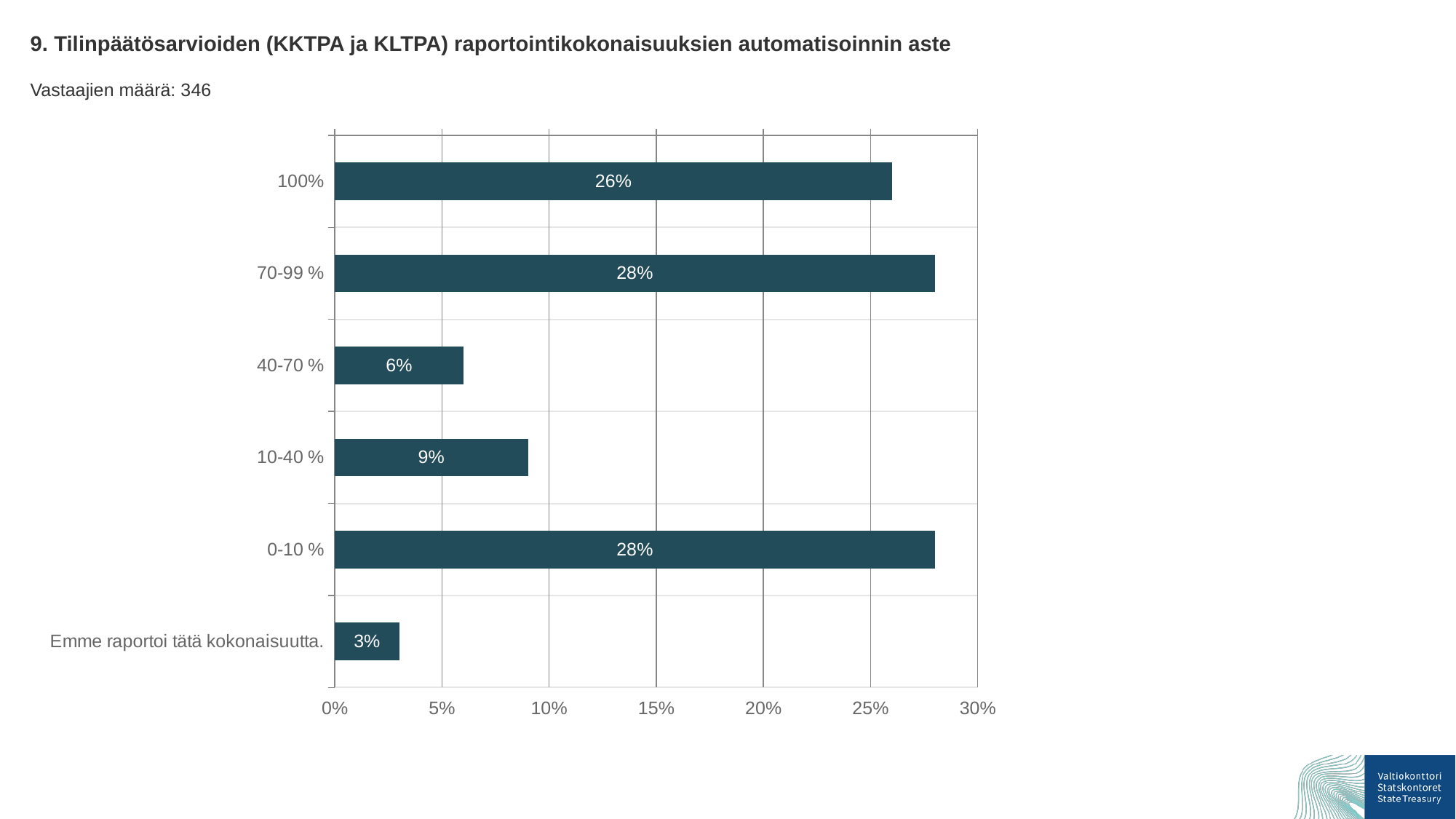
What is the value for the "40-70 %" category? 6% How many categories are shown in the chart? 6 Which is larger, the value for "100%" or the value for "10-40 %"? 100% How many respondents (Vastaajien määrä) does the slide report? 346 Which category has the lowest value? Emme raportoi tätä kokonaisuutta. What is the value for "Emme raportoi tätä kokonaisuutta."? 3% What kind of chart is shown on the slide? bar chart What is the value for the "100%" category? 26% What is the difference between the values for "70-99 %" and "40-70 %"? 22% Is the value for "0-10 %" greater or less than 25%? greater What is the value for the "10-40 %" category? 9% What is the difference between the values for "10-40 %" and "40-70 %"? 3%